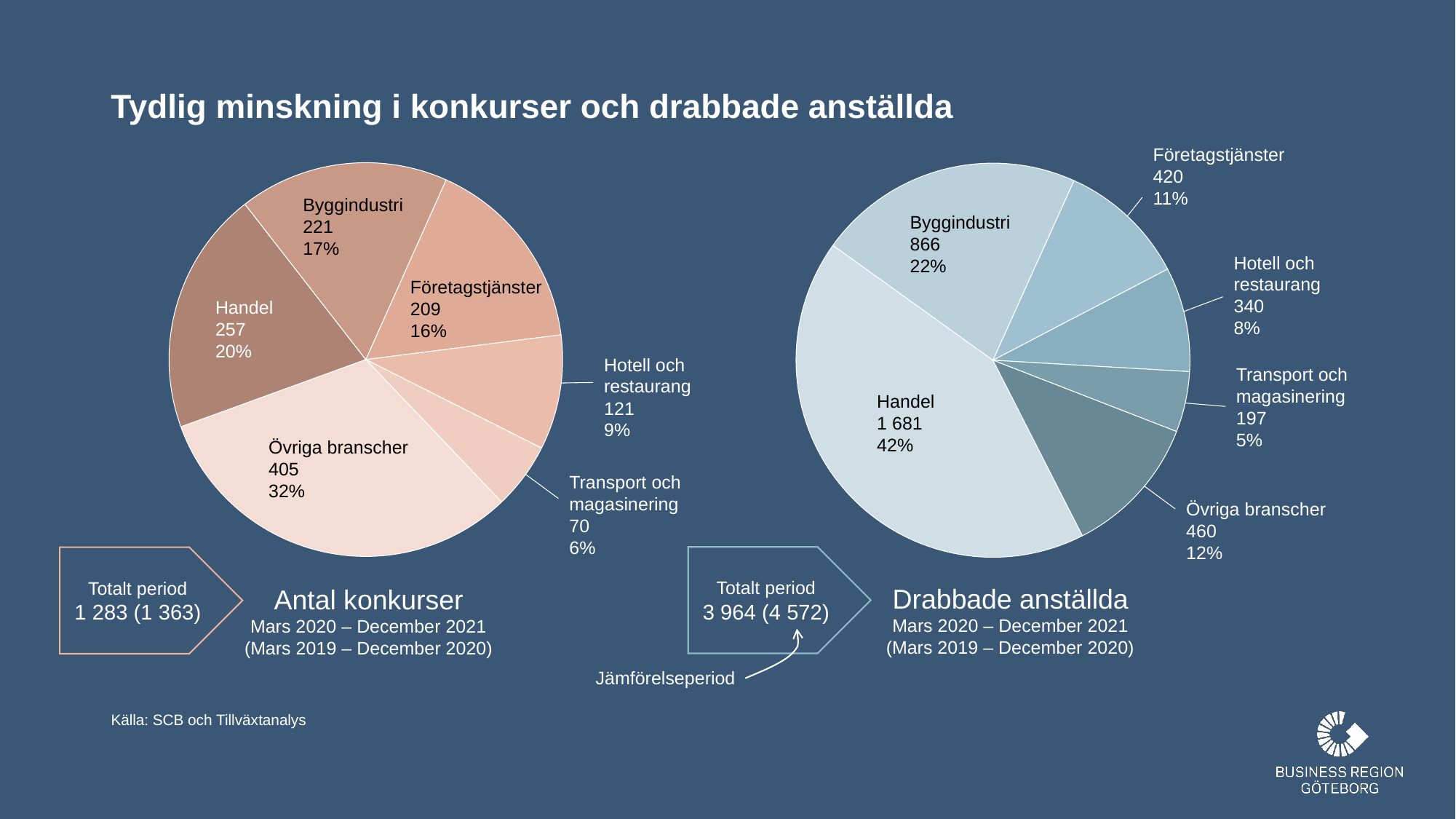
In the 'Drabbade anställda' pie chart, what is the difference between Övriga branscher and Transport och magasinering? 263 In the 'Drabbade anställda' pie chart, what share of the pie does Byggindustri represent? 22% In the 'Drabbade anställda' pie chart, which is larger: Företagstjänster or Hotell och restaurang? Företagstjänster In the 'Drabbade anställda' pie chart, what is the value for Handel? 1 681 In the 'Antal konkurser' pie chart, which category has the lowest value? Transport och magasinering In the 'Antal konkurser' pie chart, how many categories are shown? 6 In the 'Drabbade anställda' pie chart, which category has the highest value? Handel What kind of chart is used for 'Drabbade anställda'? Pie chart What is the title of the chart on the left side of the slide? Antal konkurser In the 'Antal konkurser' pie chart, what share of the pie does Övriga branscher represent? 32% In the 'Antal konkurser' pie chart, what is the value for Handel? 257 In the 'Antal konkurser' pie chart, what is the difference between Byggindustri and Företagstjänster? 12